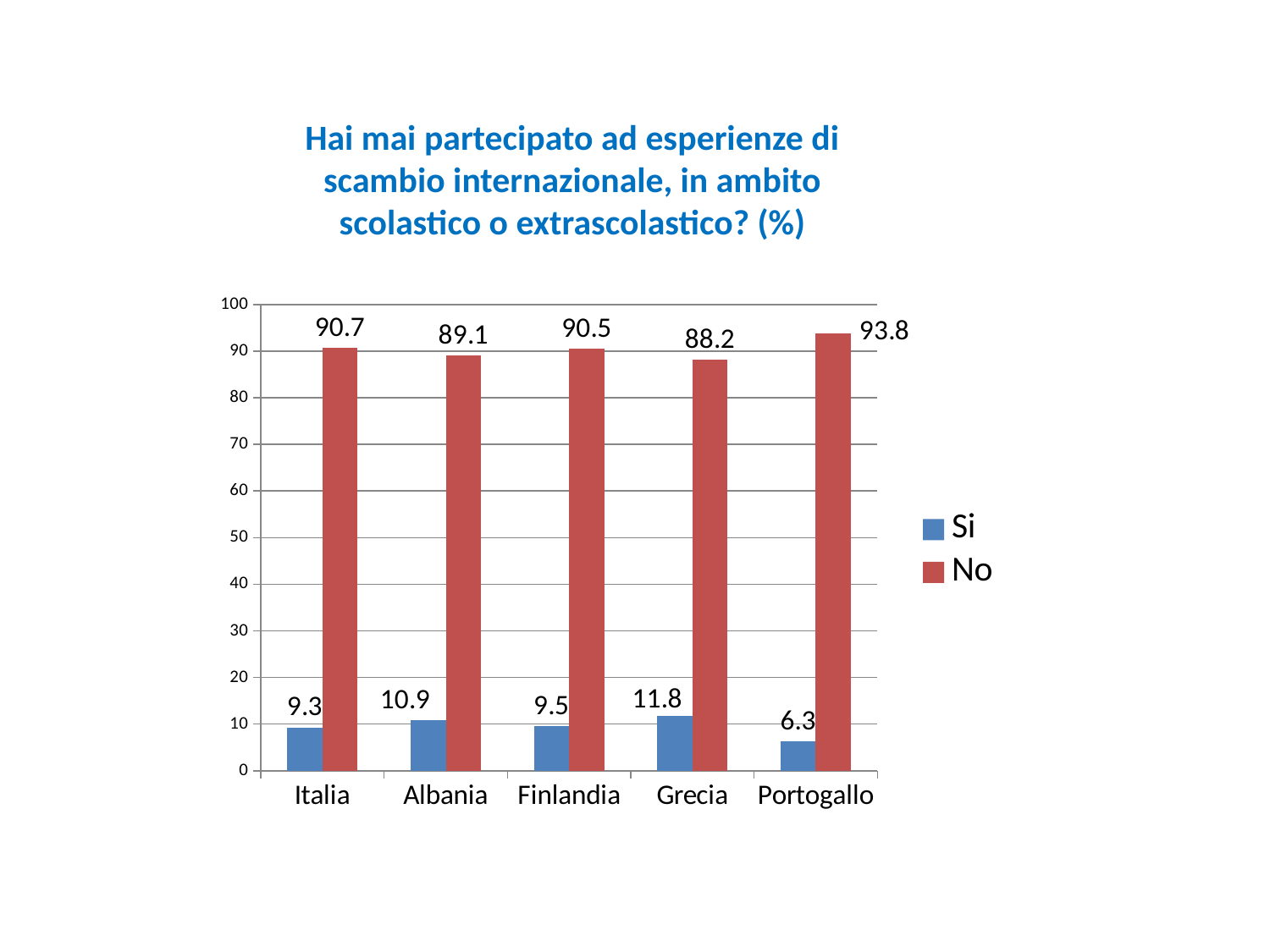
What kind of chart is shown on the slide? Bar chart What is the difference between the "No" value for Portogallo and the "No" value for Grecia? 5.6 Which country has the highest "Si" value? Grecia How many series does the legend list? 2 Which country has the lowest "Si" value? Portogallo Which is larger, the "Si" value for Albania or the "Si" value for Finlandia? Albania Which colour represents the "No" series in the chart? Red What is the value of the "Si" series for Italia? 9.3 Which country has the highest "No" value? Portogallo What is the value of the "No" series for Portogallo? 93.8 What is the value of the "Si" series for Grecia? 11.8 How many countries are shown on the x axis? 5